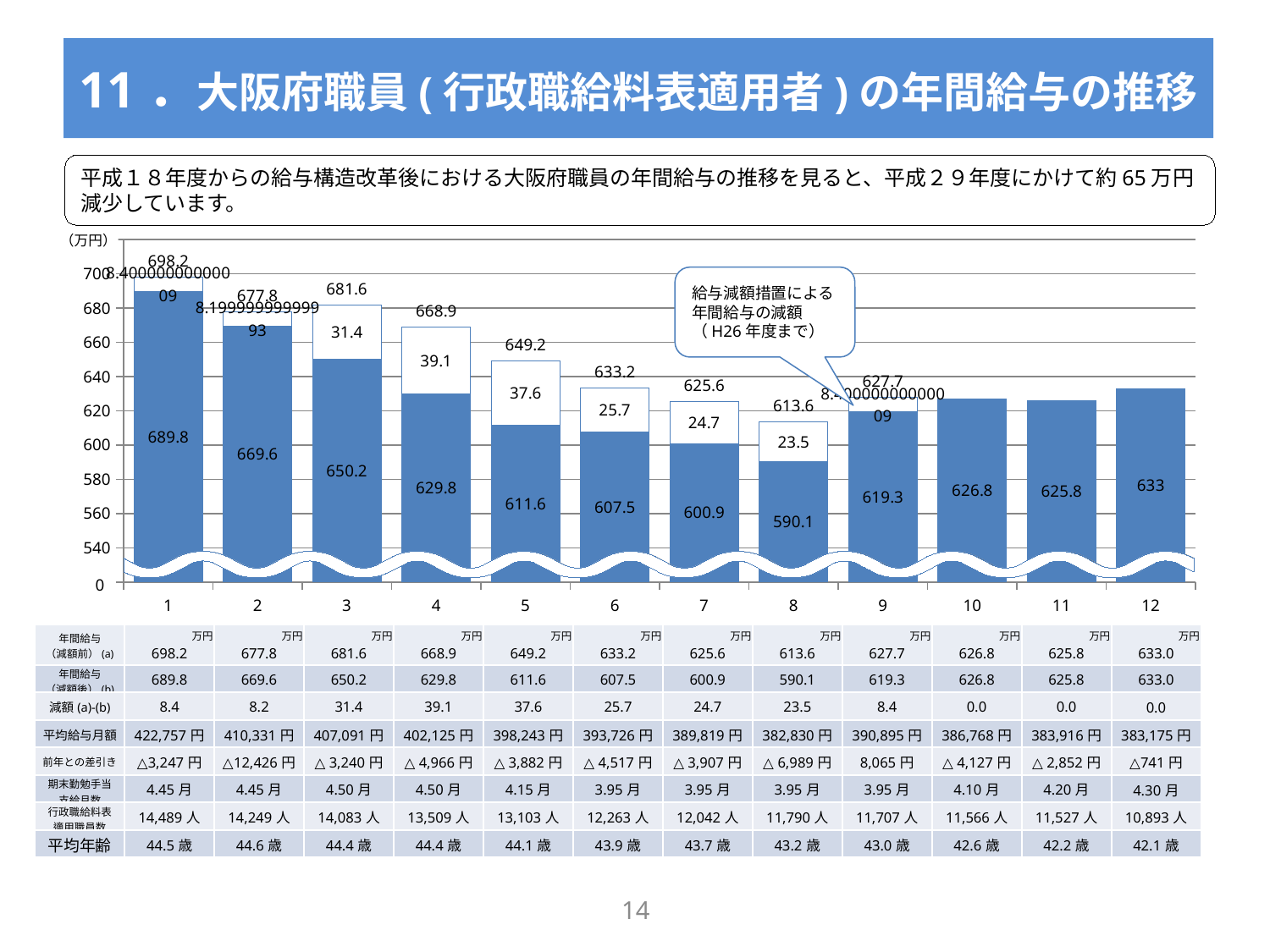
Which has the larger lower (blue) segment value, category 5 or category 6? 5 How many categories are shown on the x axis? 12 What is the value of the upper (white) segment for category 4? 39.1 What kind of chart is shown on the slide? bar chart What is the total of the stacked bar for category 3? 681.6 Do the lower (blue) segment values rise or fall from category 1 to category 8? fall Which category has the lowest value for the lower (blue) segment? 8 What is the difference between the lower (blue) segment values for category 1 and category 2? 20.2 Which category has the largest upper (white) segment? 4 Is the value of the bar for category 12 greater or less than 620? greater What is the value of the lower (blue) segment for category 8? 590.1 Which category has the highest value for the lower (blue) segment? 1